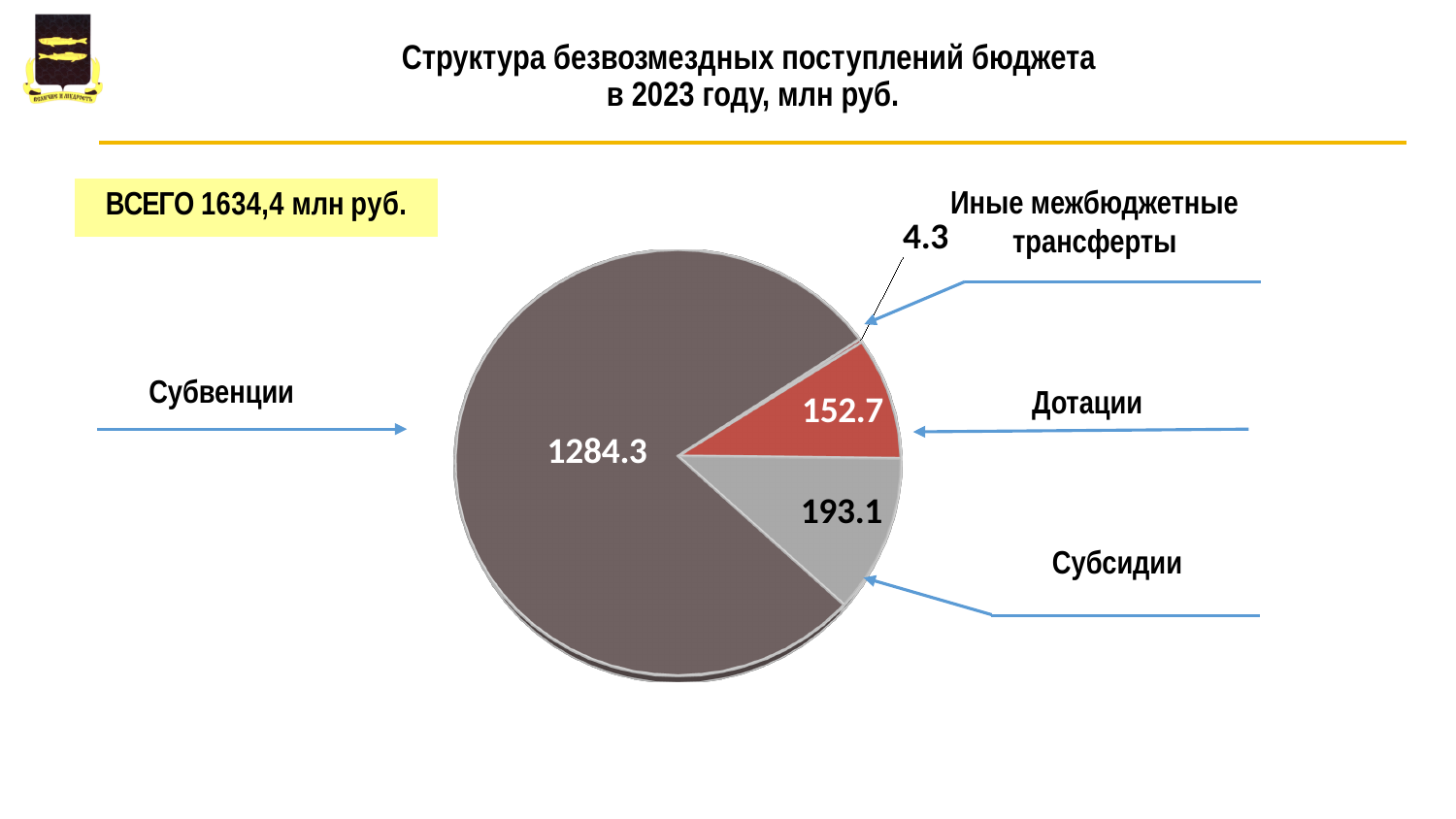
Which category has the largest slice of the pie? Субвенции What is the title of the chart? Структура безвозмездных поступлений бюджета в 2023 году, млн руб. Which is larger, Субсидии or Дотации? Субсидии What type of chart is shown on the slide? Pie chart What is the value for Иные межбюджетные трансферты? 4.3 What total amount is stated on the slide for all gratuitous receipts (ВСЕГО)? 1634,4 млн руб. What is the value for Субсидии? 193.1 What is the value for Дотации? 152.7 Which category has the smallest slice of the pie? Иные межбюджетные трансферты What is the value for Субвенции? 1284.3 How many slices does the pie chart have? 4 What is the difference between the values for Субсидии and Дотации? 40.4